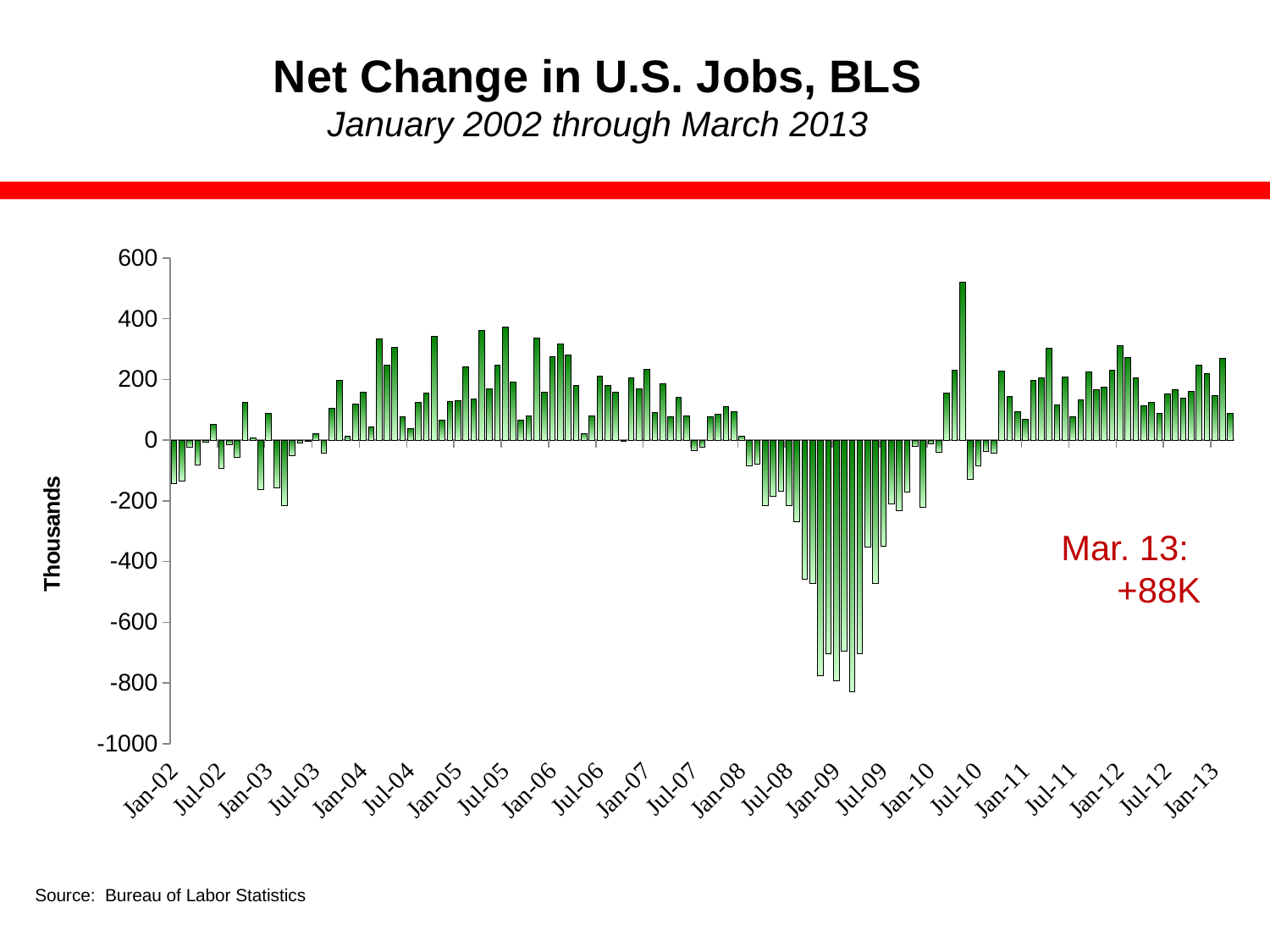
Is the tallest bar on the chart greater or less than 400? greater What is the lowest tick value shown on the vertical axis? -1000 Do the values generally rise or fall from Jan-08 to Jan-09? fall In which year does the lowest bar on the chart occur? 2009 What is the label on the vertical axis? Thousands In which year does the tallest bar on the chart occur? 2010 What is the net change in U.S. jobs for March 2013 as labeled on the chart? +88K What is the title of the chart? Net Change in U.S. Jobs, BLS What kind of chart is shown on the slide? bar chart Is the value for Jan-13 greater or less than 0? greater Is the value for Jan-02 greater or less than 0? less